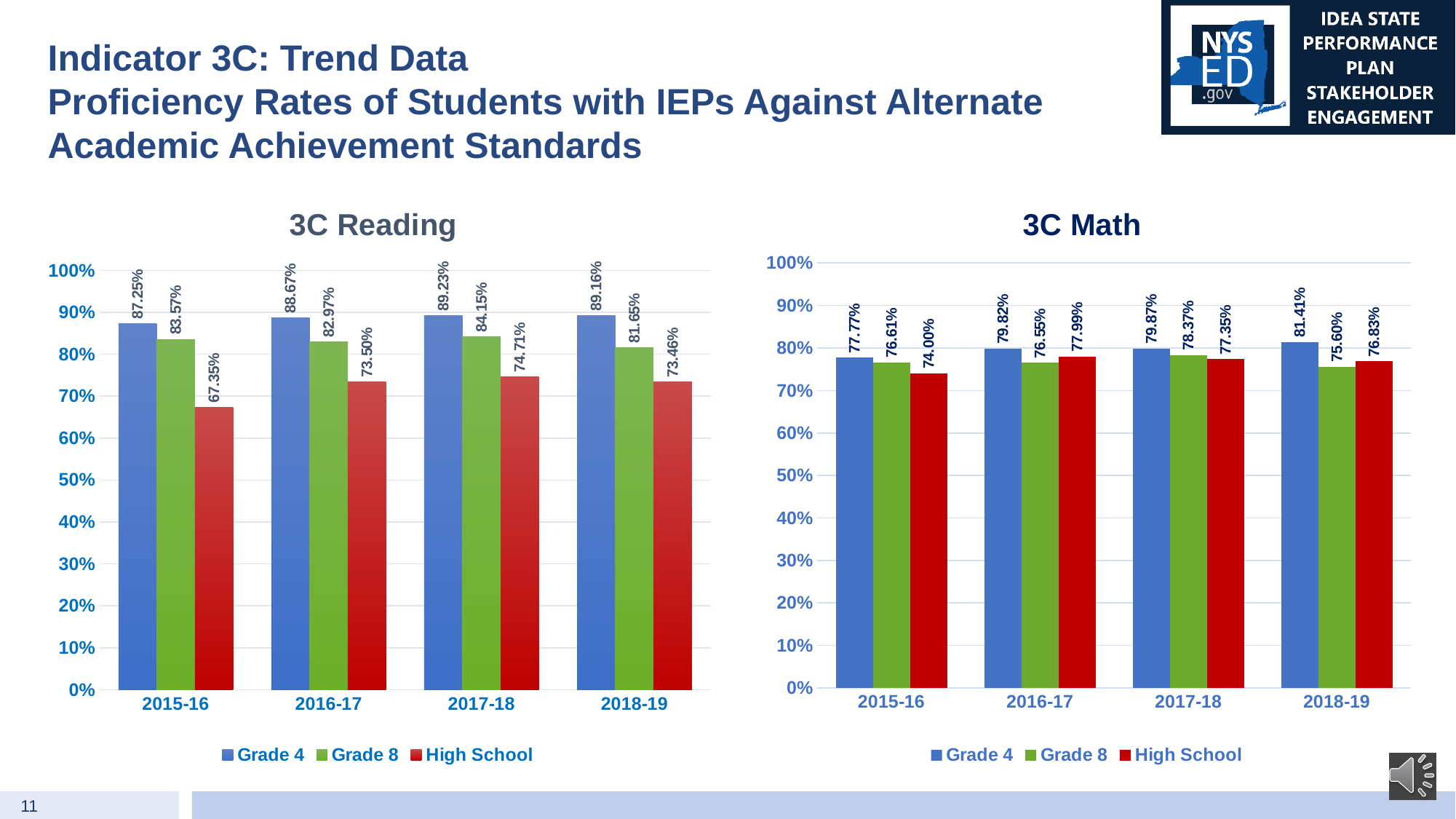
In the 3C Reading chart, does the Grade 4 value rise or fall from 2015-16 to 2017-18? rise What type of chart is the 3C Math chart? bar chart How many series does the legend of the 3C Reading chart list? 3 In the 3C Math chart, which is larger for 2016-17: Grade 8 or High School? High School In the 3C Math chart, which year has the highest Grade 4 value? 2018-19 In the 3C Reading chart, what is the High School value for 2017-18? 74.71% In the 3C Reading chart, which year has the lowest High School value? 2015-16 In the 3C Math chart, what is the High School value for 2015-16? 74.00% How many years are shown on the x axis of the 3C Math chart? 4 In the 3C Reading chart, what is the difference between the Grade 4 and High School values for 2015-16? 19.90% In the 3C Math chart, what is the Grade 8 value for 2018-19? 75.60% In the 3C Reading chart, what is the Grade 4 value for 2015-16? 87.25%